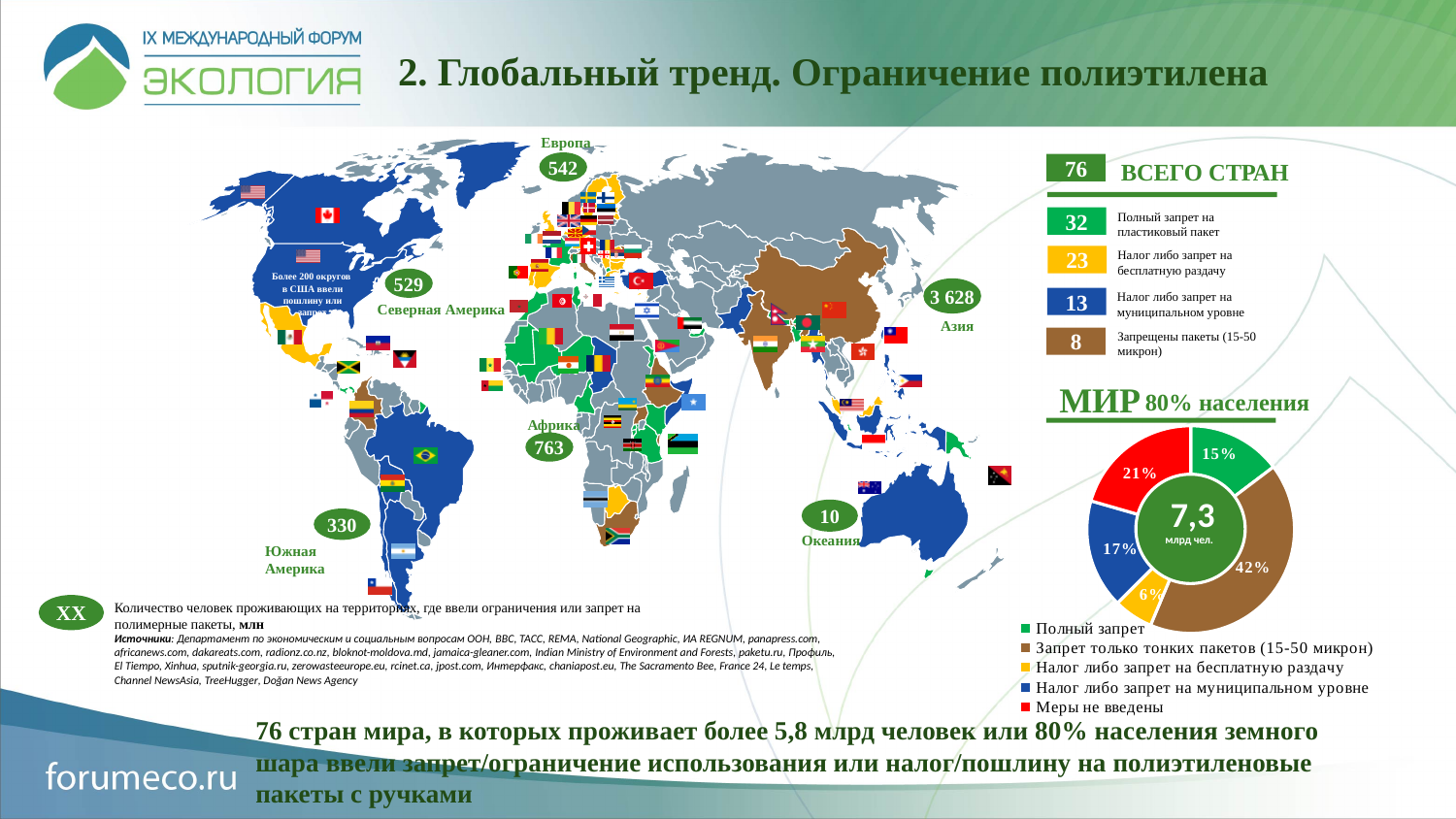
What value is printed in the centre of the 'МИР 80% населения' donut chart? 7,3 млрд чел. Which category has the largest slice in the 'МИР 80% населения' chart? Запрет только тонких пакетов (15-50 микрон) In the 'МИР 80% населения' chart, which is larger: 'Меры не введены' or 'Налог либо запрет на муниципальном уровне'? Меры не введены In the 'МИР 80% населения' chart, what share is shown for 'Запрет только тонких пакетов (15-50 микрон)'? 42% How many categories does the legend of the 'МИР 80% населения' chart list? 5 Which category has the smallest slice in the 'МИР 80% населения' chart? Налог либо запрет на бесплатную раздачу In the 'МИР 80% населения' chart, what share is shown for 'Налог либо запрет на бесплатную раздачу'? 6% In the 'МИР 80% населения' chart, what share is shown for 'Полный запрет'? 15% What kind of chart is the 'МИР 80% населения' chart? Pie (donut) chart In the 'МИР 80% населения' chart, what is the difference between the 'Меры не введены' share and the 'Полный запрет' share? 6%